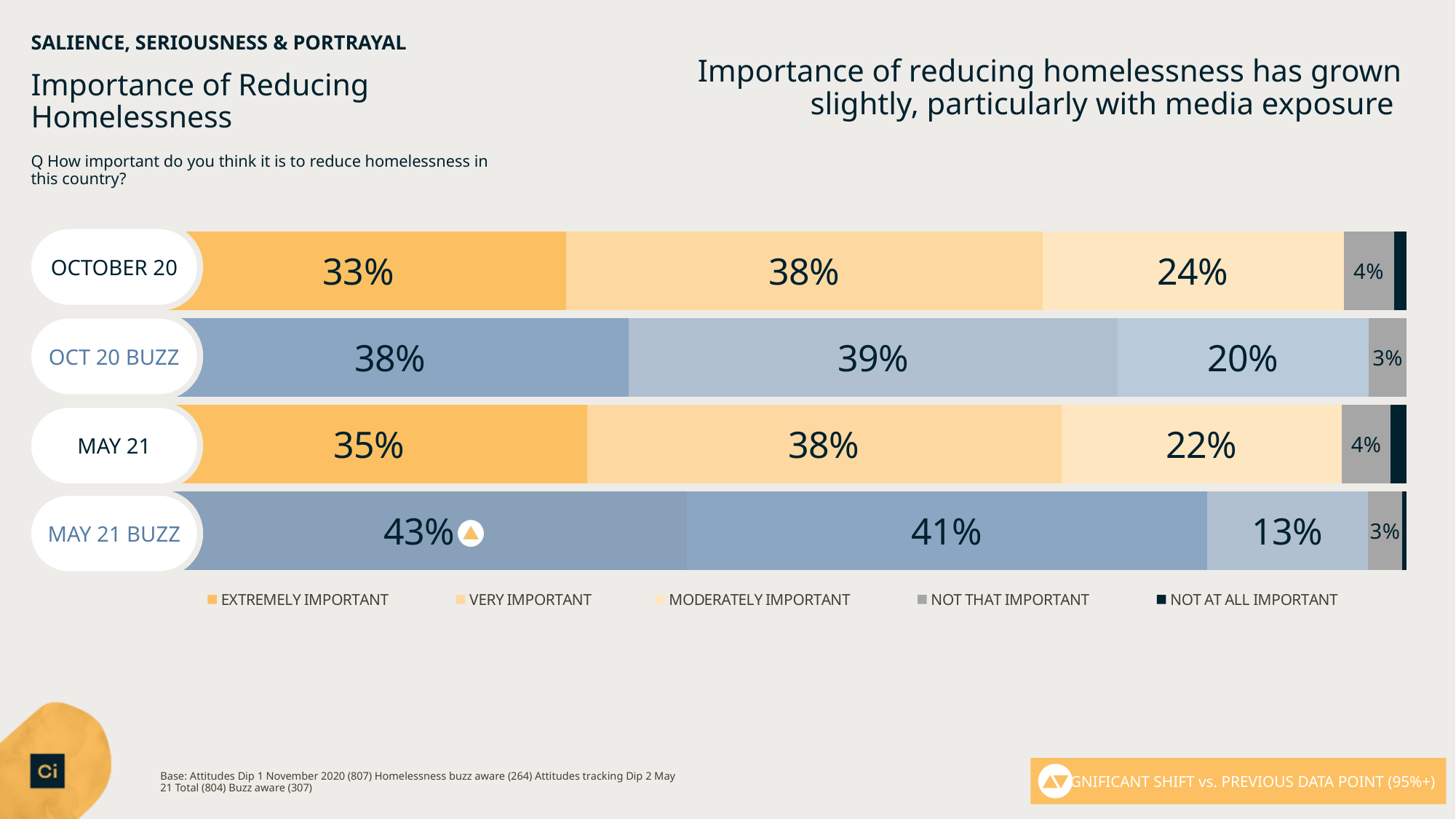
How many response categories does the legend list? 5 What is the 'Not that important' value for May 21? 4% Which bar carries the significant shift marker (triangle)? May 21 Buzz How many groups (bars) are shown in the chart? 4 What percentage of respondents in the May 21 Buzz group said reducing homelessness is extremely important? 43% By how many percentage points does the 'Extremely important' share for May 21 Buzz exceed that for Oct 20 Buzz? 5 percentage points Which is larger: the 'Very important' share for October 20 or for May 21 Buzz? May 21 Buzz Which group has the highest 'Extremely important' share? May 21 Buzz What is the 'Moderately important' value for October 20? 24% What is the 'Very important' value for Oct 20 Buzz? 39% What type of chart is used on this slide? Stacked bar chart Which group has the lowest 'Moderately important' share? May 21 Buzz